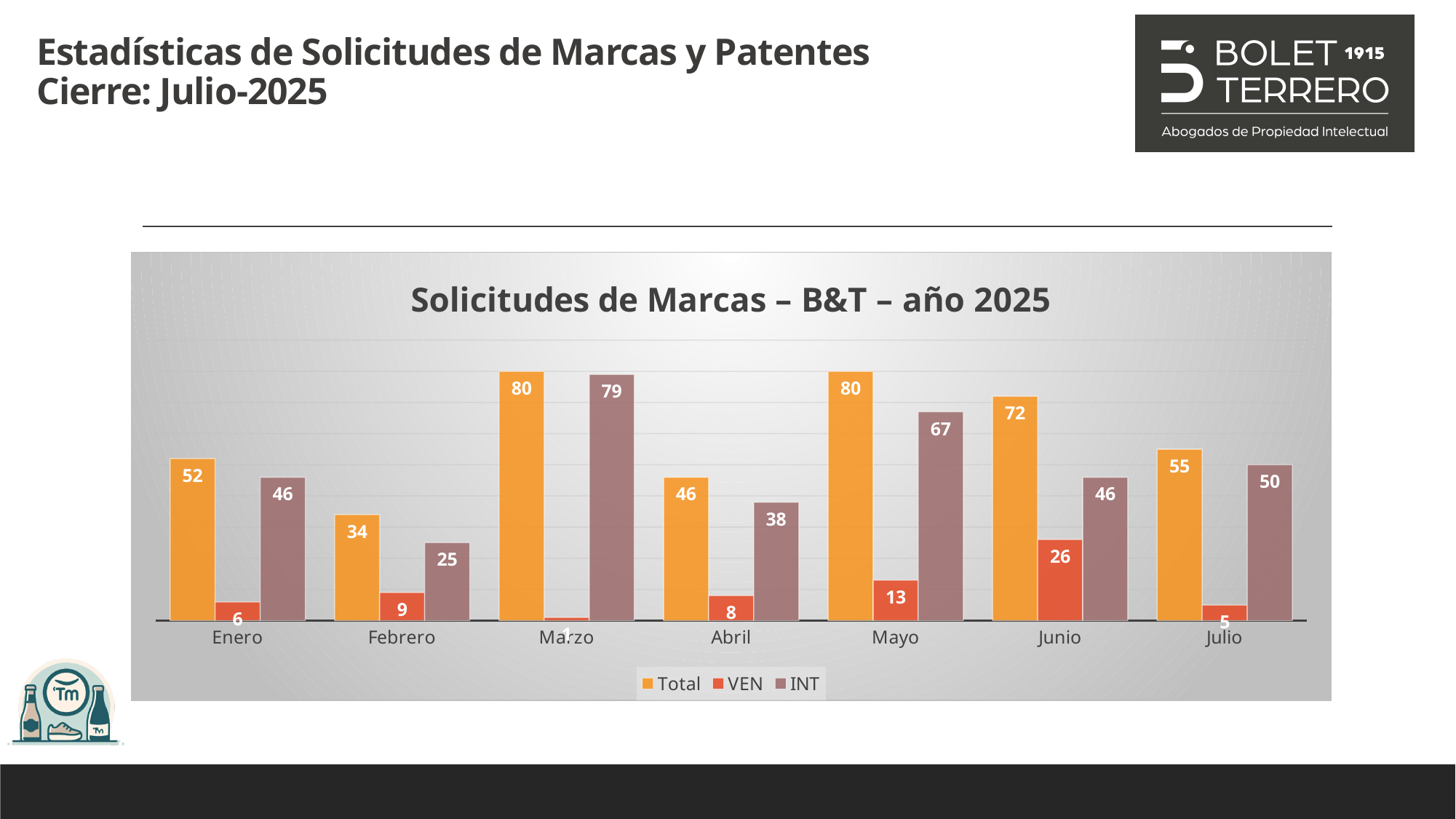
Which month has the highest VEN value? Junio What is the VEN value for Junio? 26 What is the INT value for Mayo? 67 What kind of chart is shown on the slide? Bar chart What is the difference between the Total values for Junio and Julio? 17 Which is larger, the INT value for Abril or the INT value for Julio? Julio What is the title of the chart? Solicitudes de Marcas – B&T – año 2025 What is the Total value for Enero? 52 How many series does the legend list? 3 Which month has the highest INT value? Marzo Which month has the lowest Total value? Febrero How many months are shown on the x axis? 7